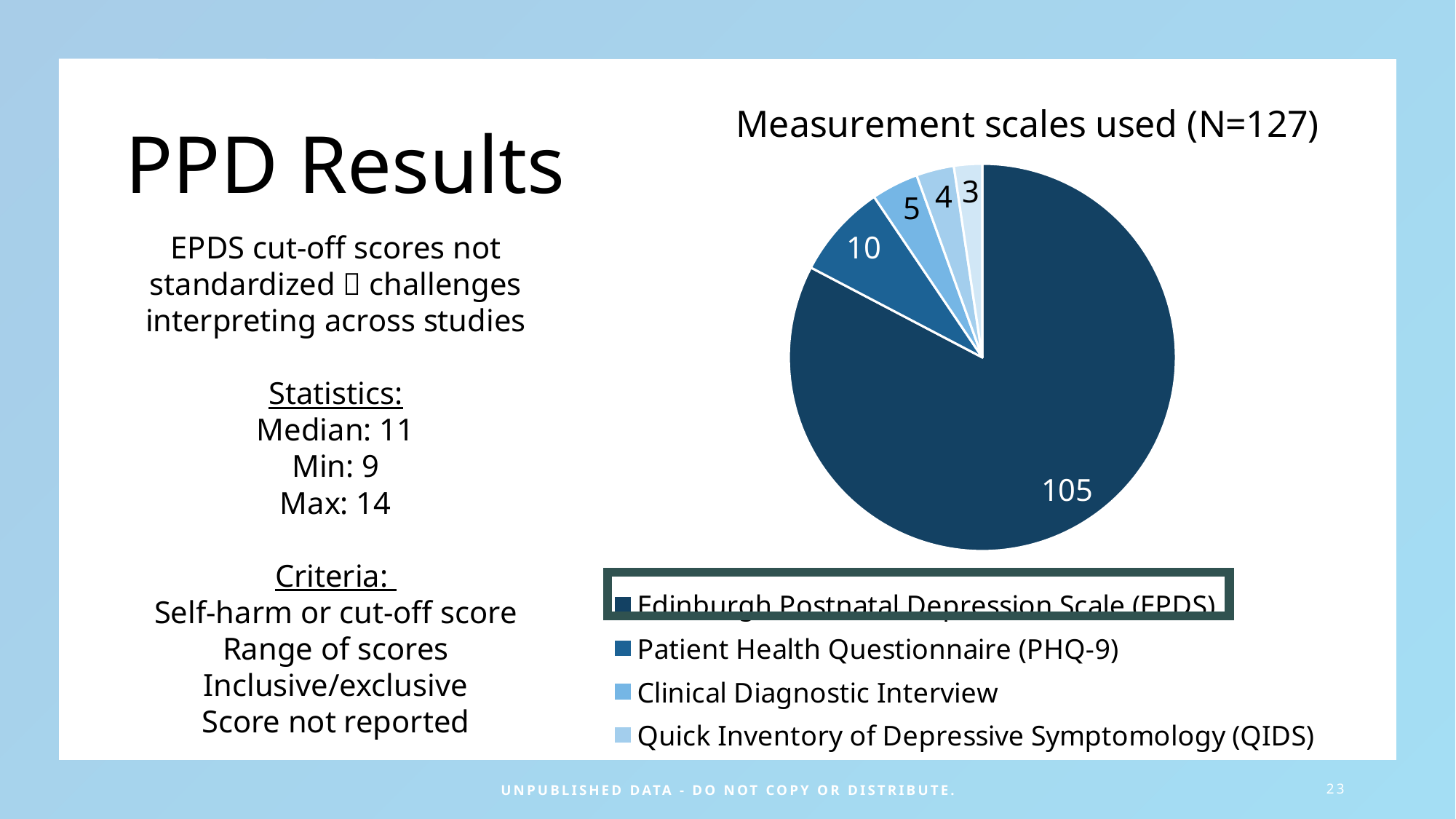
Which measurement scale has the largest slice of the pie? Edinburgh Postnatal Depression Scale (EPDS) What is the value for Quick Inventory of Depressive Symptomology (QIDS)? 4 What kind of chart is shown on the slide? pie chart What is the title of the chart? Measurement scales used (N=127) How many studies used the Edinburgh Postnatal Depression Scale (EPDS)? 105 How many slices does the pie chart have? 5 What is the value for Clinical Diagnostic Interview? 5 Which is larger, the value for Patient Health Questionnaire (PHQ-9) or the value for Clinical Diagnostic Interview? Patient Health Questionnaire (PHQ-9) What is the difference between the EPDS value and the PHQ-9 value? 95 How many entries does the chart legend list? 4 What is the smallest value labelled on the pie chart? 3 What is the value for Patient Health Questionnaire (PHQ-9)? 10